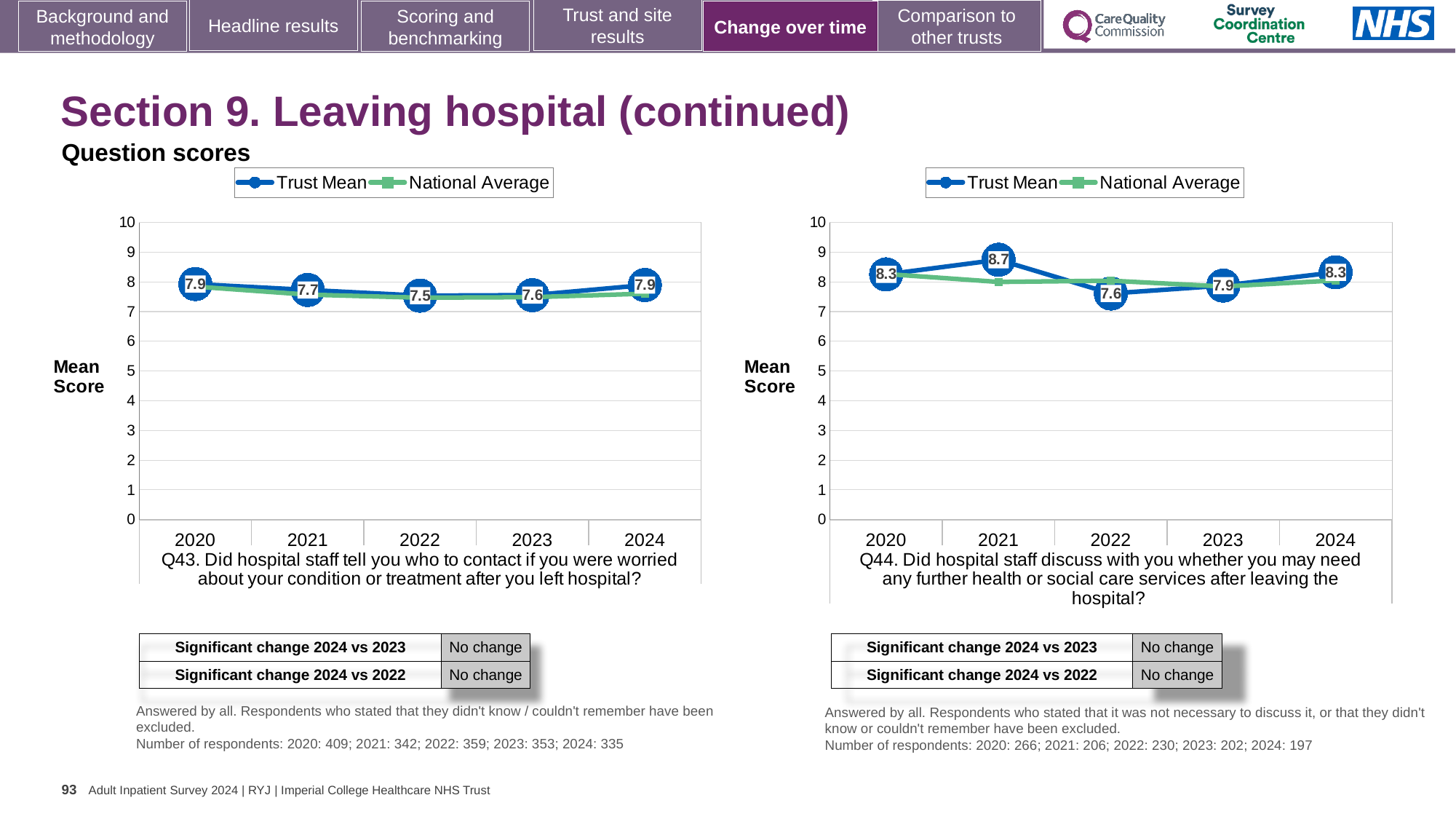
In the Q44 chart on the right, what is the Trust Mean score for 2021? 8.7 How many series does the legend of the Q44 chart on the right list? 2 In the Q44 chart on the right, is the Trust Mean score for 2023 higher or lower than for 2022? higher What type of chart is the Q43 chart on the left? line chart In the Q44 chart on the right, what is the difference between the Trust Mean scores for 2021 and 2022? 1.1 In the Q43 chart on the left, what is the difference between the Trust Mean scores for 2024 and 2022? 0.4 How many years are plotted on the x axis of the Q43 chart on the left? 5 In the Q43 chart on the left, what is the Trust Mean score for 2024? 7.9 In the Q44 chart on the right, what is the Trust Mean score for 2022? 7.6 In the Q43 chart on the left, what is the Trust Mean score for 2022? 7.5 In the Q44 chart on the right, which year has the highest Trust Mean score? 2021 In the Q43 chart on the left, which year has the lowest Trust Mean score? 2022